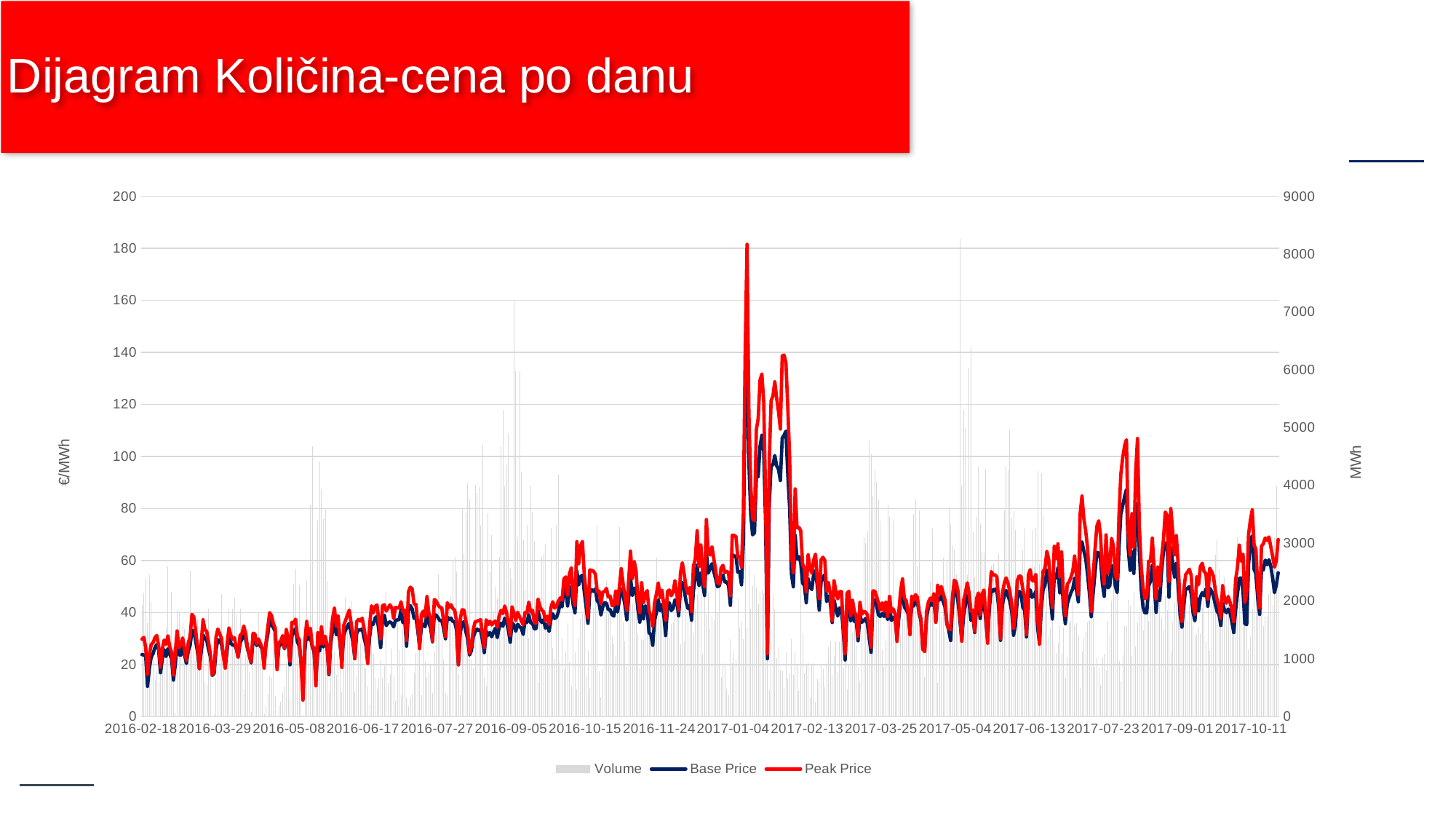
How many series does the legend list? 3 Which series is drawn as a red line? Peak Price What is the maximum value shown on the left vertical axis? 200 What unit is shown on the right vertical axis? MWh What is the first date label on the x axis? 2016-02-18 Is the highest Peak Price spike greater or less than 160 €/MWh? greater Around which x-axis date does the Peak Price reach its highest spike? 2017-01-04 What is the maximum value shown on the right vertical axis? 9000 At the spike near 2017-01-04, which is larger, the Peak Price or the Base Price? Peak Price What are the names of the series listed in the legend? Volume, Base Price, Peak Price What is the title of the slide containing the chart? Dijagram Količina-cena po danu What unit is shown on the left vertical axis? €/MWh